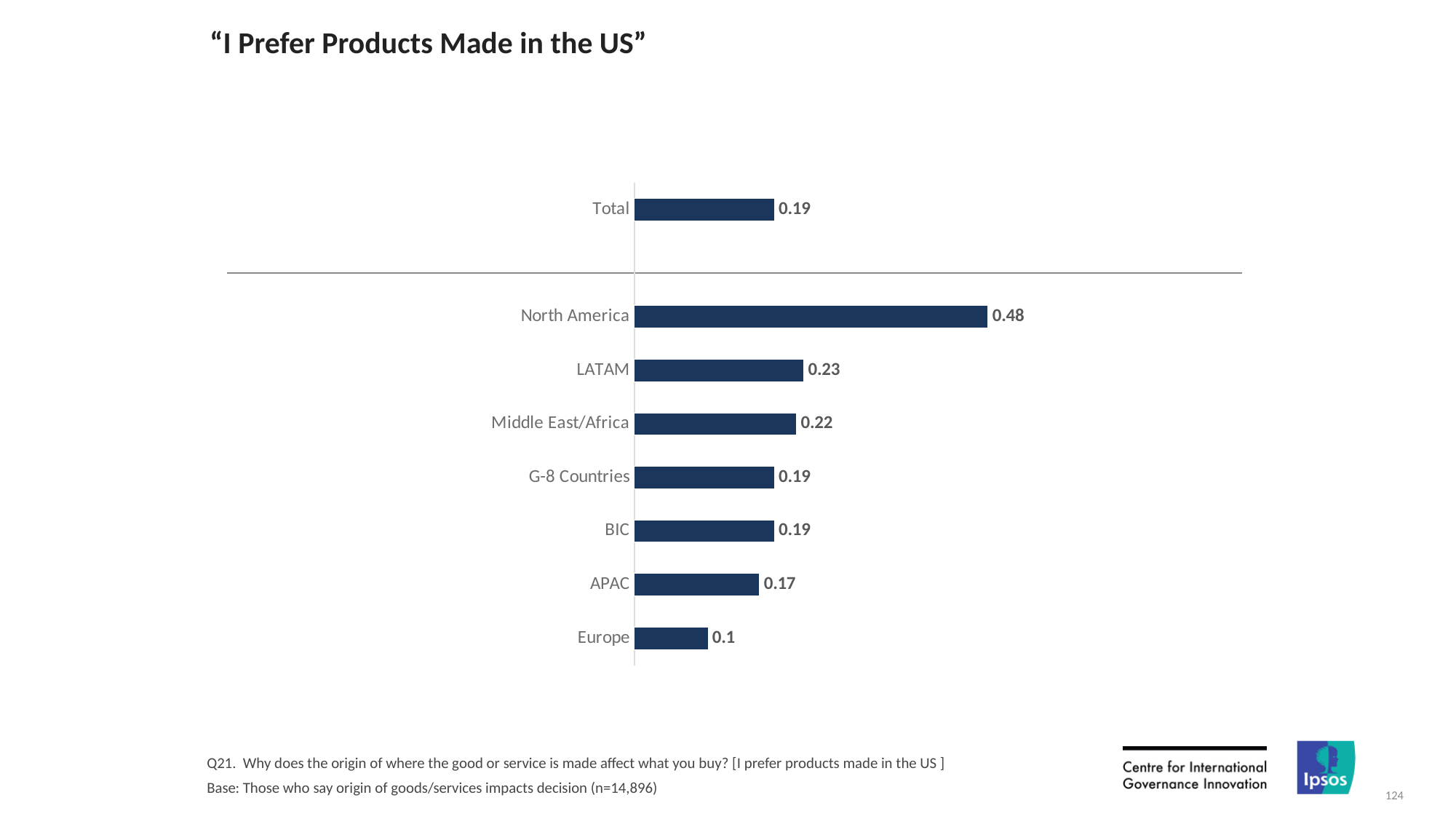
What is the title of the chart? "I Prefer Products Made in the US" What is the difference between the values for North America and LATAM? 0.25 Which region has the highest value? North America What is the value for North America? 0.48 What kind of chart is shown on the slide? Bar chart Which is larger, the value for LATAM or the value for APAC? LATAM What is the value for Europe? 0.1 What is the value for Middle East/Africa? 0.22 What is the value for APAC? 0.17 What is the value for Total? 0.19 How many bars are shown on the chart, including Total? 8 Which region has the lowest value? Europe